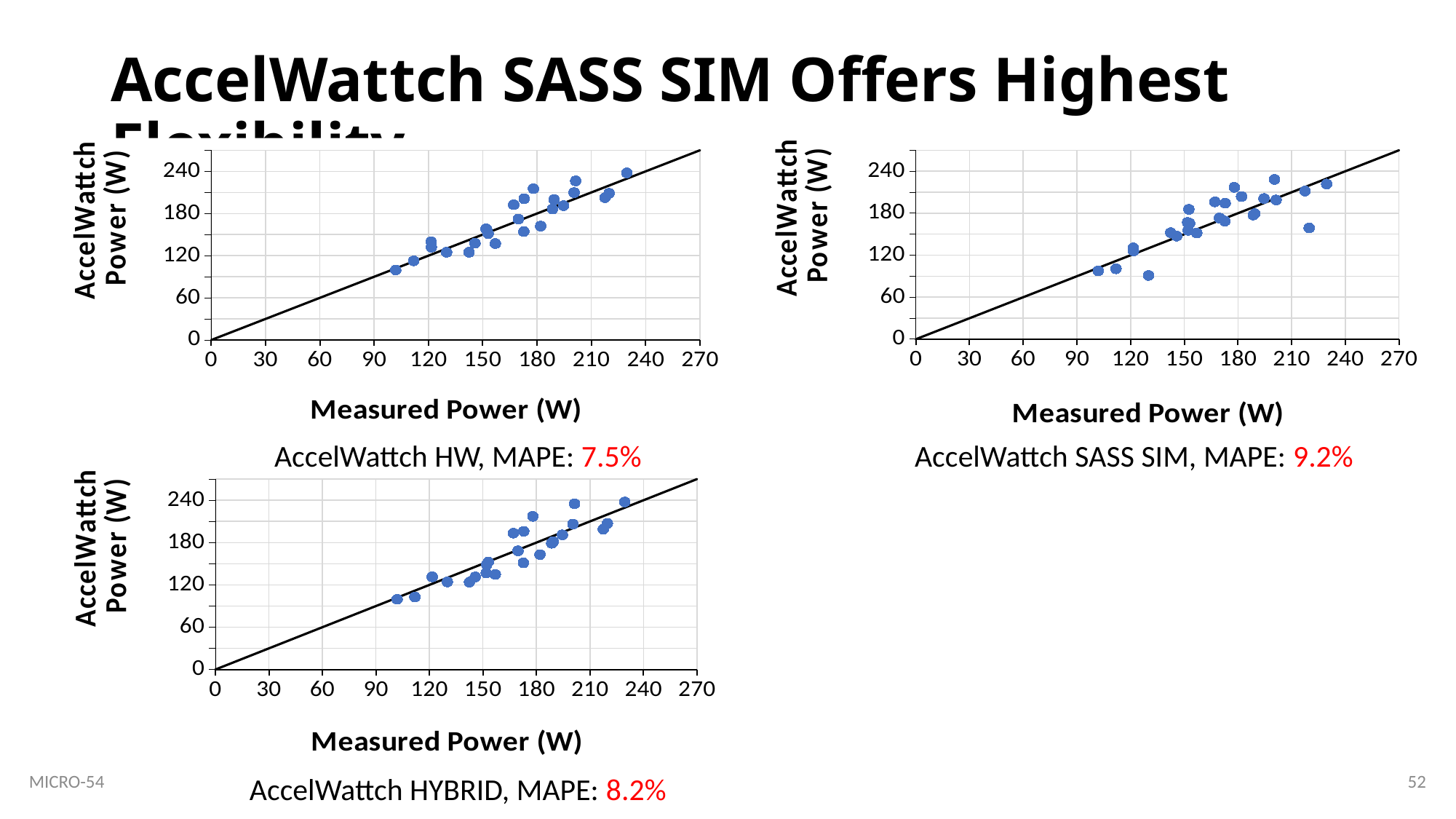
In the AccelWattch SASS SIM chart, is the AccelWattch Power value for the point at about 220 W measured power that lies well below the line greater or less than 180? less What kind of chart is the top-left chart labelled AccelWattch HW? scatter chart In the AccelWattch HYBRID chart, is the AccelWattch Power value for the leftmost point (at about 100 W measured power) greater or less than 120? less In the AccelWattch HW chart, is the AccelWattch Power value for the highest point near 180 W measured power greater or less than 180? greater In the AccelWattch HW chart, do the AccelWattch Power values generally rise or fall as Measured Power increases? rise What is the y-axis title of the AccelWattch HYBRID chart? AccelWattch Power (W) How many charts are shown on the slide? 3 What is the highest tick value shown on the x axis of the AccelWattch HYBRID chart? 270 What is the x-axis title of the AccelWattch SASS SIM chart? Measured Power (W) In the AccelWattch SASS SIM chart, do the plotted points generally rise or fall along the x axis? rise